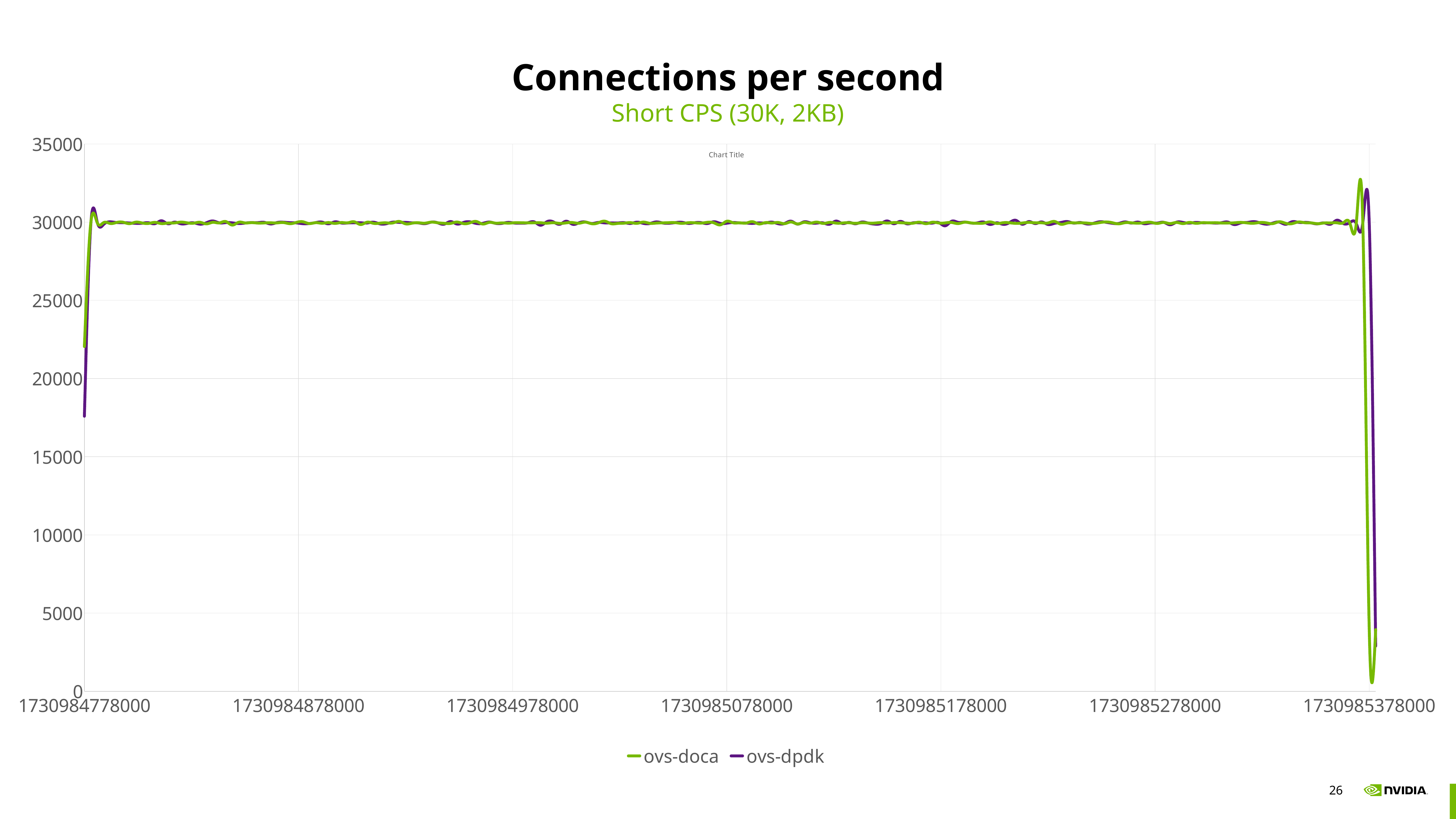
How many series does the legend list? 2 Do the values for both series rise or fall at the far right end of the x axis? fall What kind of chart is shown on the slide? line chart Which colour is used for the ovs-dpdk series? purple What is the first label on the x axis? 1730984778000 Is the very first plotted value for ovs-dpdk greater or less than 20000? less What is the highest value shown on the y axis? 35000 What are the two series named in the legend? ovs-doca and ovs-dpdk Is the very last plotted value for ovs-doca greater or less than 5000? less How many labelled tick marks are on the x axis? 7 Across the middle of the chart, is the value for ovs-doca greater or less than 25000? greater